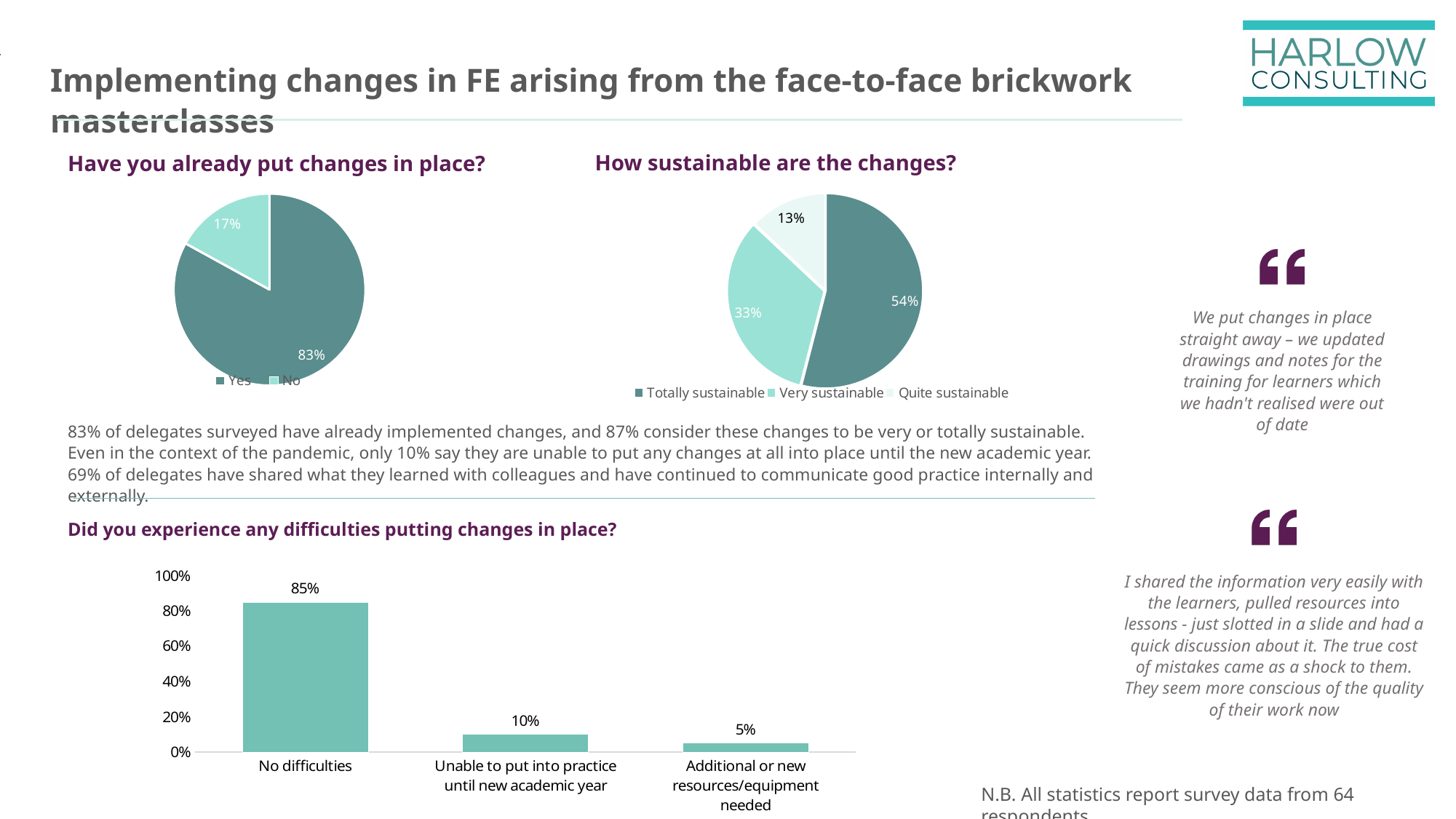
In the 'How sustainable are the changes?' pie chart, what share is labelled Totally sustainable? 54% What kind of chart is 'Did you experience any difficulties putting changes in place?'? Bar chart In the 'How sustainable are the changes?' pie chart, what share is labelled Quite sustainable? 13% In the 'Did you experience any difficulties putting changes in place?' chart, what is the difference between 'No difficulties' and 'Unable to put into practice until new academic year'? 75% In the 'How sustainable are the changes?' pie chart, how many categories does the legend list? 3 In the 'Did you experience any difficulties putting changes in place?' chart, what is the value for 'No difficulties'? 85% In the 'How sustainable are the changes?' pie chart, which category has the smallest slice? Quite sustainable In the 'Did you experience any difficulties putting changes in place?' chart, what is the value for 'Additional or new resources/equipment needed'? 5% In the 'Did you experience any difficulties putting changes in place?' chart, which category has the lowest value? Additional or new resources/equipment needed In the 'Have you already put changes in place?' pie chart, what share of respondents answered Yes? 83% In the 'How sustainable are the changes?' pie chart, what is the difference between the Totally sustainable and Very sustainable shares? 21%